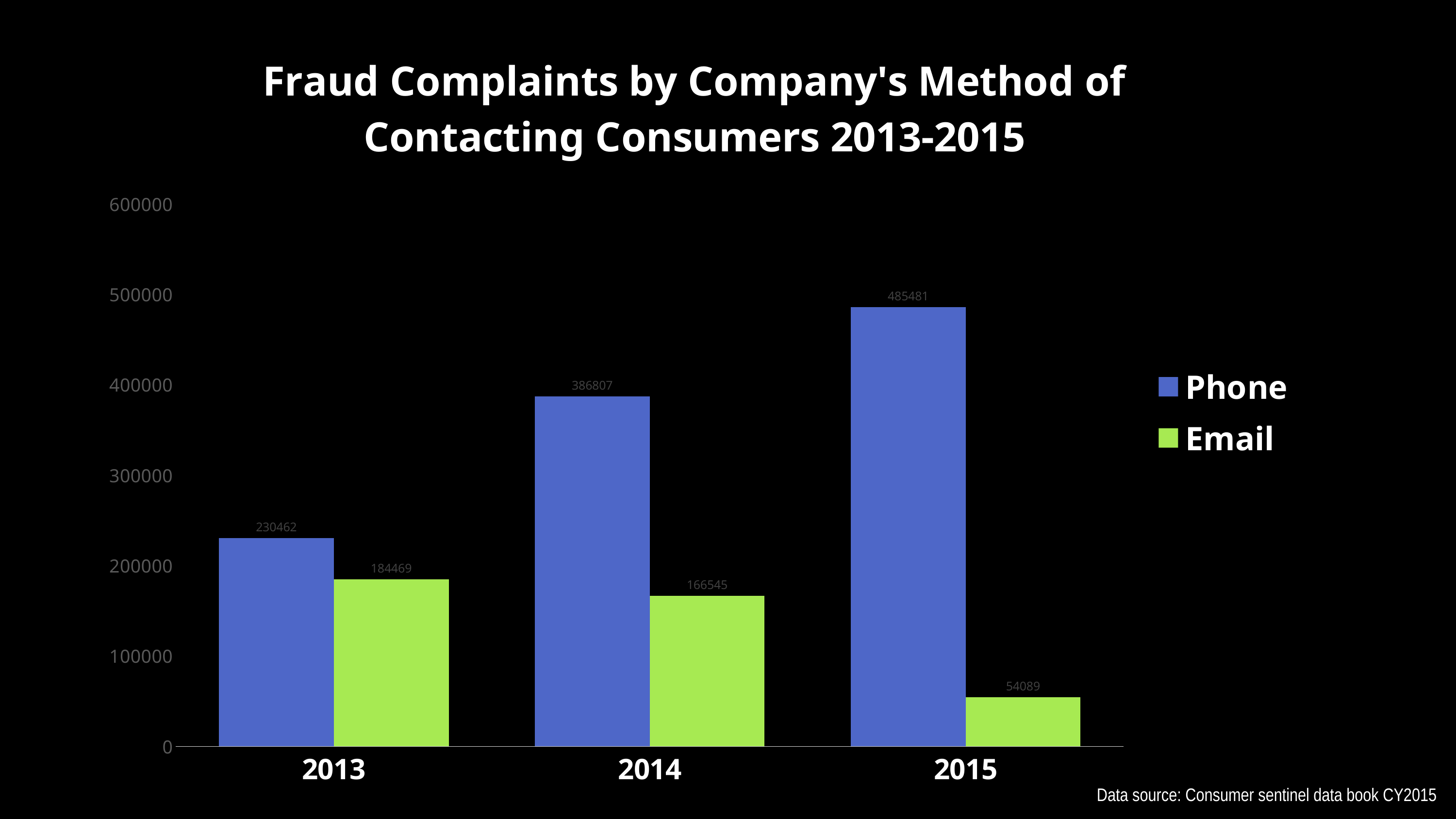
Do the Email values rise or fall from 2013 to 2015? fall What is the difference between the Phone and Email values in 2015? 431392 What is the value for Email in 2013? 184469 Which is larger in 2013, Phone or Email? Phone In which year is the Phone value highest? 2015 How many years are shown on the x axis? 3 Is the value for Phone in 2015 greater or less than 400000? greater What is the value for Phone in 2014? 386807 What kind of chart is shown? bar chart What is the value for Email in 2015? 54089 In which year is the Email value lowest? 2015 How many series does the legend list? 2